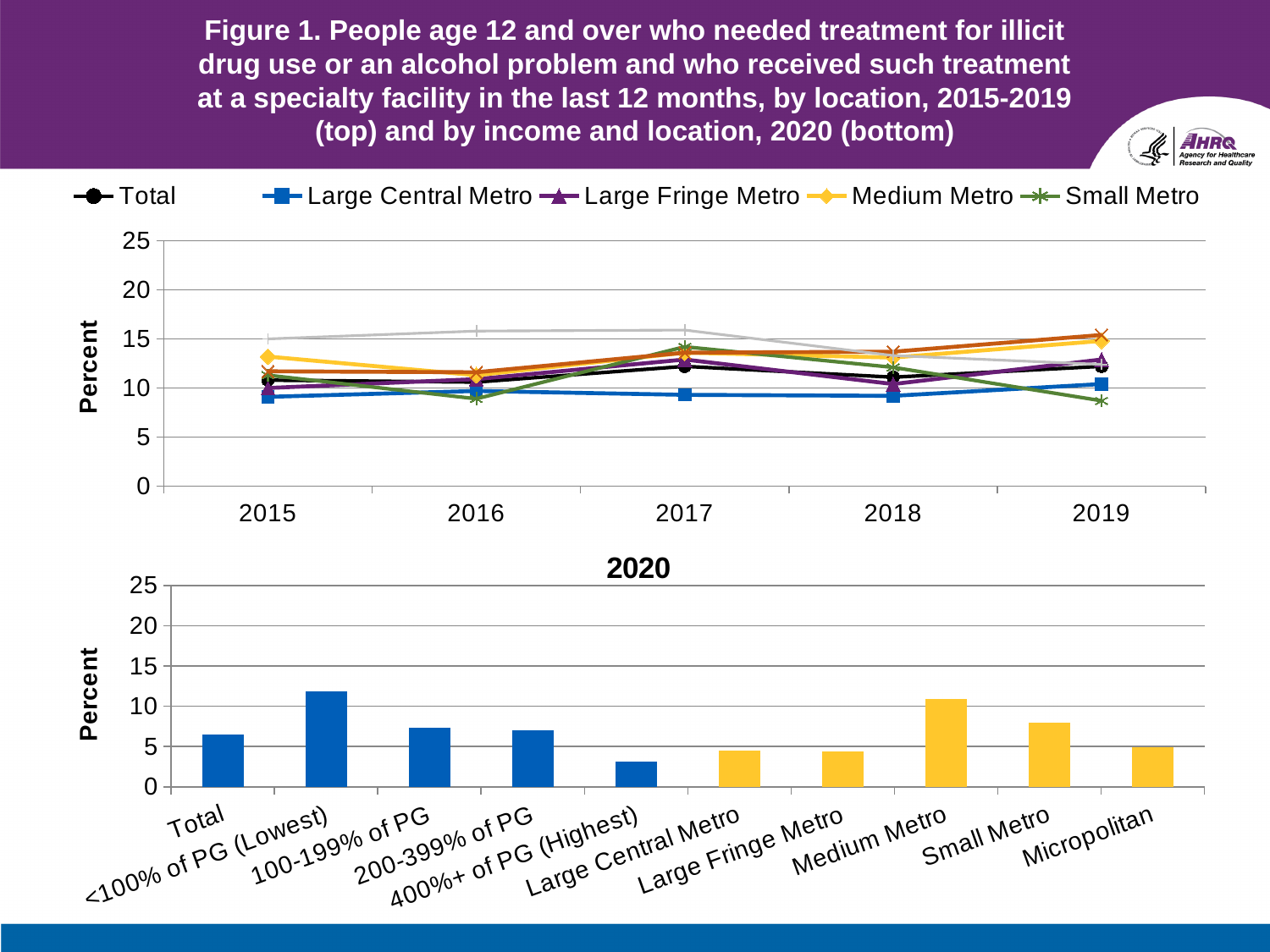
In the top chart, is the value for Small Metro in 2019 greater or less than 10? less What is the label on the y axis of the bottom chart titled 2020? Percent In the bottom chart titled 2020, is the value for Medium Metro greater or less than 10? greater How many bars are shown in the bottom chart titled 2020? 10 In the bottom chart titled 2020, which category has the lowest value? 400%+ of PG (Highest) In the bottom chart titled 2020, is the value for 400%+ of PG (Highest) greater or less than 5? less What kind of chart is the bottom chart titled 2020? Bar chart How many series does the legend of the top chart list? 5 What kind of chart is the top chart (2015-2019 by location)? Line chart In the top chart, which is higher in 2019: Medium Metro or Small Metro? Medium Metro How many years are shown on the x axis of the top chart? 5 In the bottom chart titled 2020, which category has the highest value? <100% of PG (Lowest)